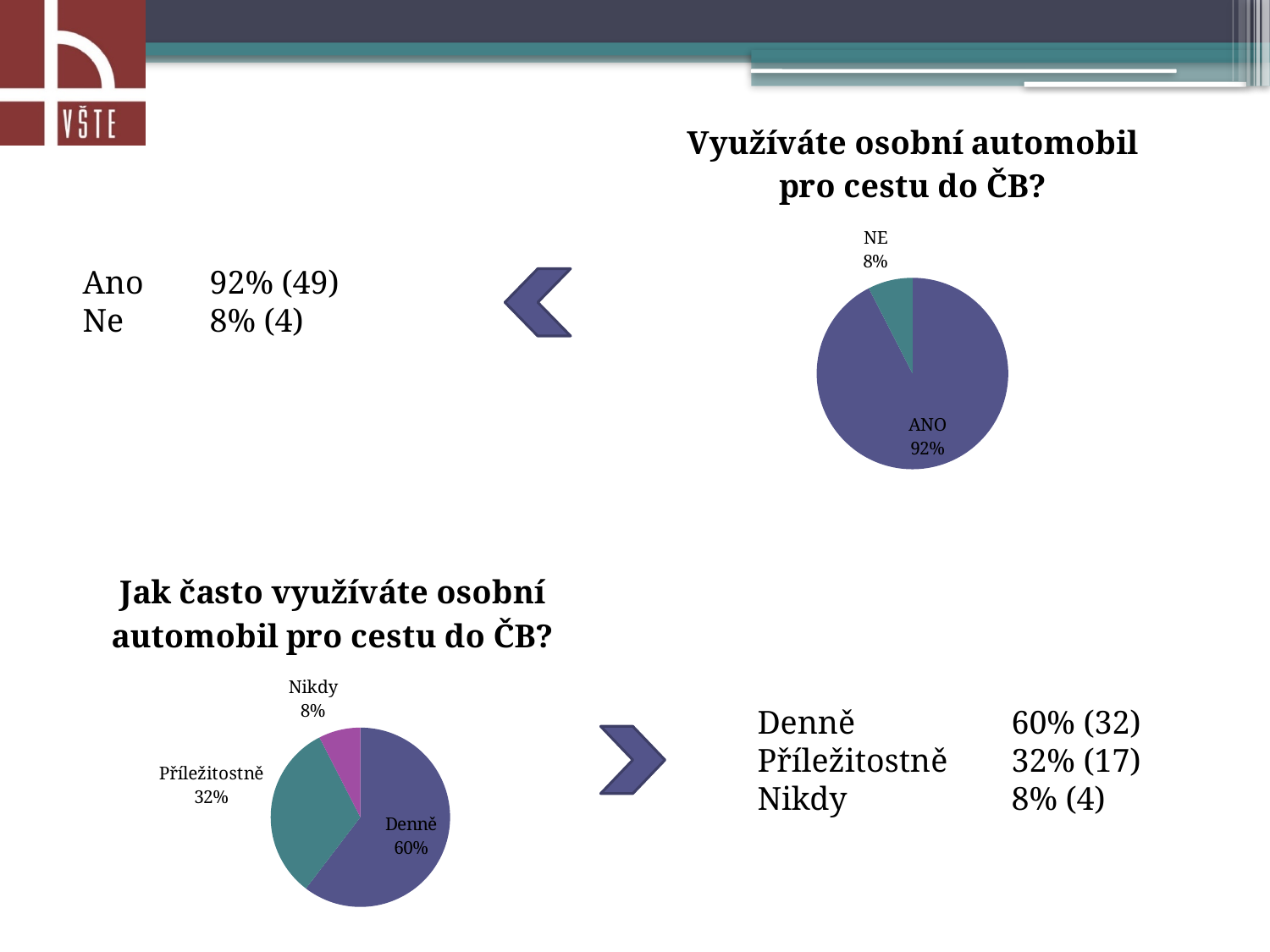
In the chart titled 'Jak často využíváte osobní automobil pro cestu do ČB?', what is the difference in percentage points between the Denně and Příležitostně slices? 28% In the chart titled 'Jak často využíváte osobní automobil pro cestu do ČB?', what share of the pie is labelled Denně? 60% In the chart titled 'Využíváte osobní automobil pro cestu do ČB?', which slice is the largest? ANO In the chart titled 'Jak často využíváte osobní automobil pro cestu do ČB?', which slice is larger, Příležitostně or Nikdy? Příležitostně In the chart titled 'Jak často využíváte osobní automobil pro cestu do ČB?', how many slices does the pie have? 3 In the chart titled 'Jak často využíváte osobní automobil pro cestu do ČB?', which slice is the smallest? Nikdy In the chart titled 'Jak často využíváte osobní automobil pro cestu do ČB?', what share of the pie is labelled Nikdy? 8% In the chart titled 'Využíváte osobní automobil pro cestu do ČB?', what share of the pie is labelled ANO? 92% What kind of chart is the one titled 'Využíváte osobní automobil pro cestu do ČB?'? pie chart In the chart titled 'Využíváte osobní automobil pro cestu do ČB?', how many slices does the pie have? 2